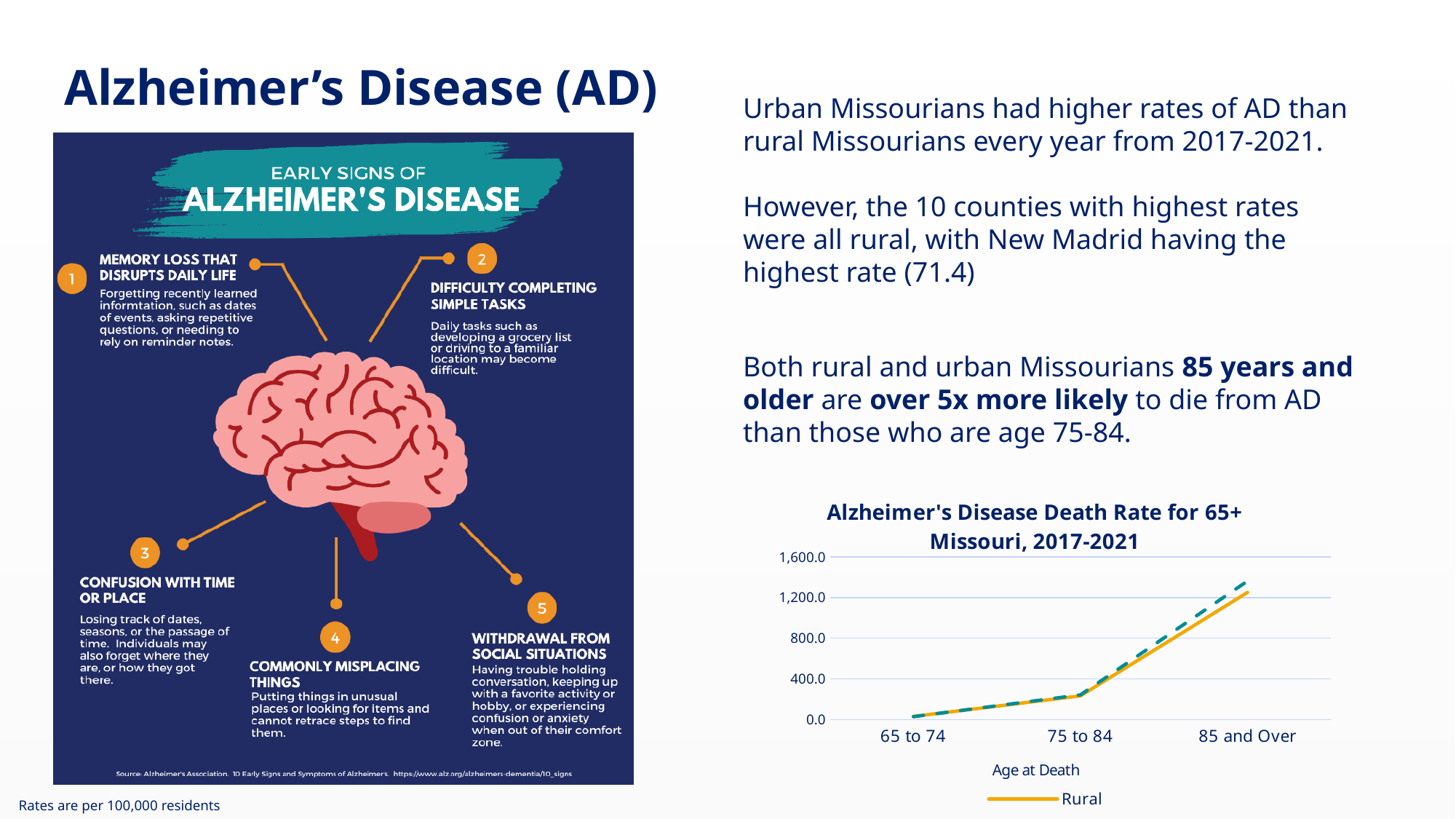
Is the Rural value for 75 to 84 greater or less than 400.0? less What is the label of the x axis of the chart? Age at Death What kind of chart is shown on the slide? line chart Is the Rural value for 85 and Over greater or less than 800.0? greater How many age categories are shown on the x axis of the chart? 3 Do the values in the chart rise or fall as age at death increases? rise Which is larger for the Rural series: the value for 85 and Over or the value for 75 to 84? 85 and Over Which age category has the lowest Rural death rate in the chart? 65 to 74 Is the Rural value for 85 and Over greater or less than 1,600.0? less What is the title of the chart on the slide? Alzheimer's Disease Death Rate for 65+ Missouri, 2017-2021 Which age category has the highest Rural death rate in the chart? 85 and Over